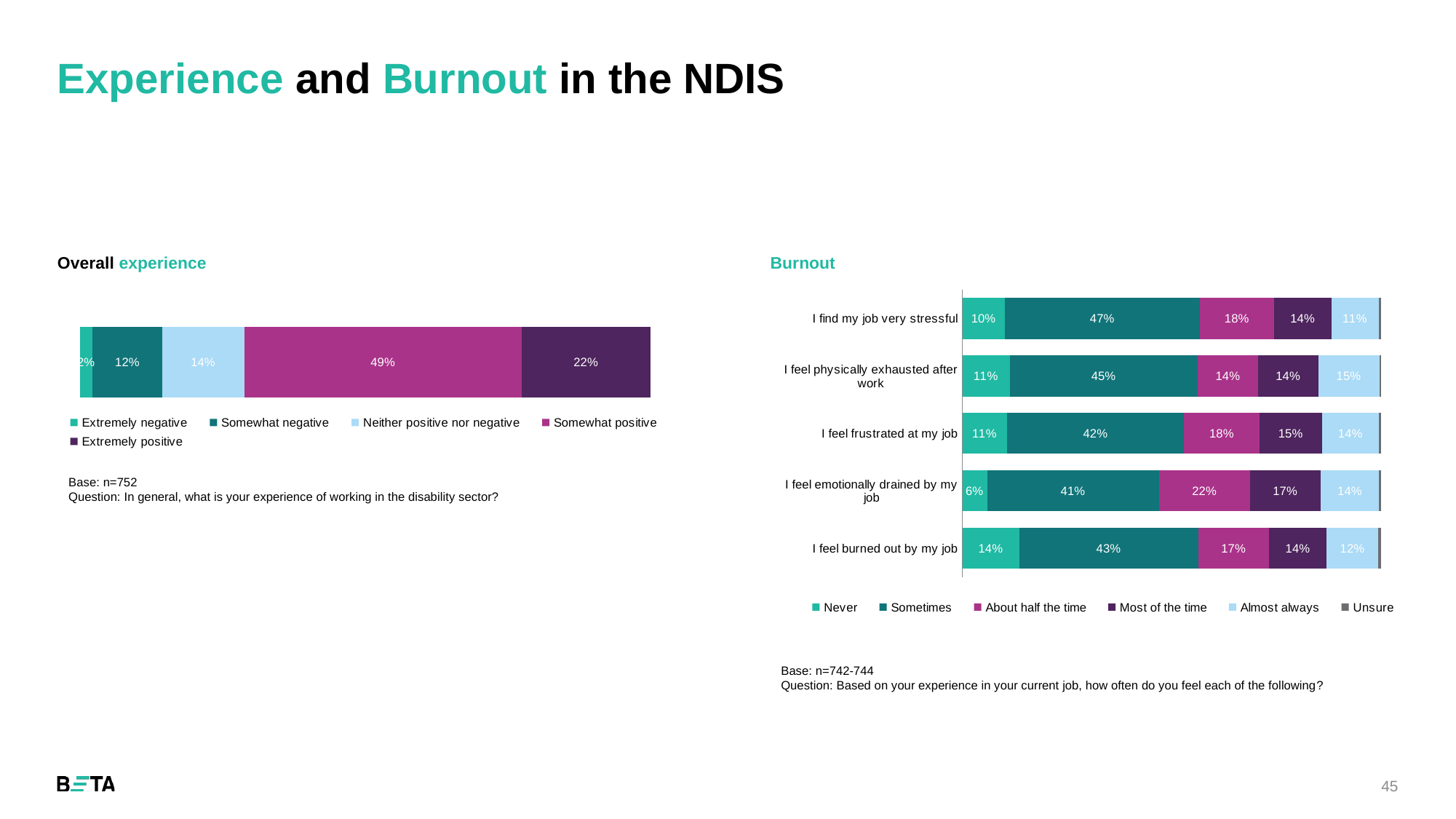
In the Burnout chart, which statement has the highest 'About half the time' percentage? I feel emotionally drained by my job In the Overall experience chart, what percentage of respondents reported an extremely positive experience? 22% In the Overall experience chart, how many categories does the legend list? 5 In the Overall experience chart, which response category has the largest share? Somewhat positive In the Overall experience chart, what percentage of respondents reported a somewhat positive experience? 49% In the Burnout chart, which is larger: the 'Never' percentage for 'I feel burned out by my job' or for 'I feel emotionally drained by my job'? I feel burned out by my job In the Burnout chart, what is the difference between the 'Sometimes' percentages for 'I find my job very stressful' and 'I feel emotionally drained by my job'? 6% In the Burnout chart, what percentage said they 'Sometimes' find their job very stressful? 47% What type of chart is the Burnout chart? Stacked bar chart In the Burnout chart, what percentage said they 'Never' feel emotionally drained by their job? 6% In the Burnout chart, what percentage said they 'Almost always' feel physically exhausted after work? 15% How many statements are plotted in the Burnout chart? 5